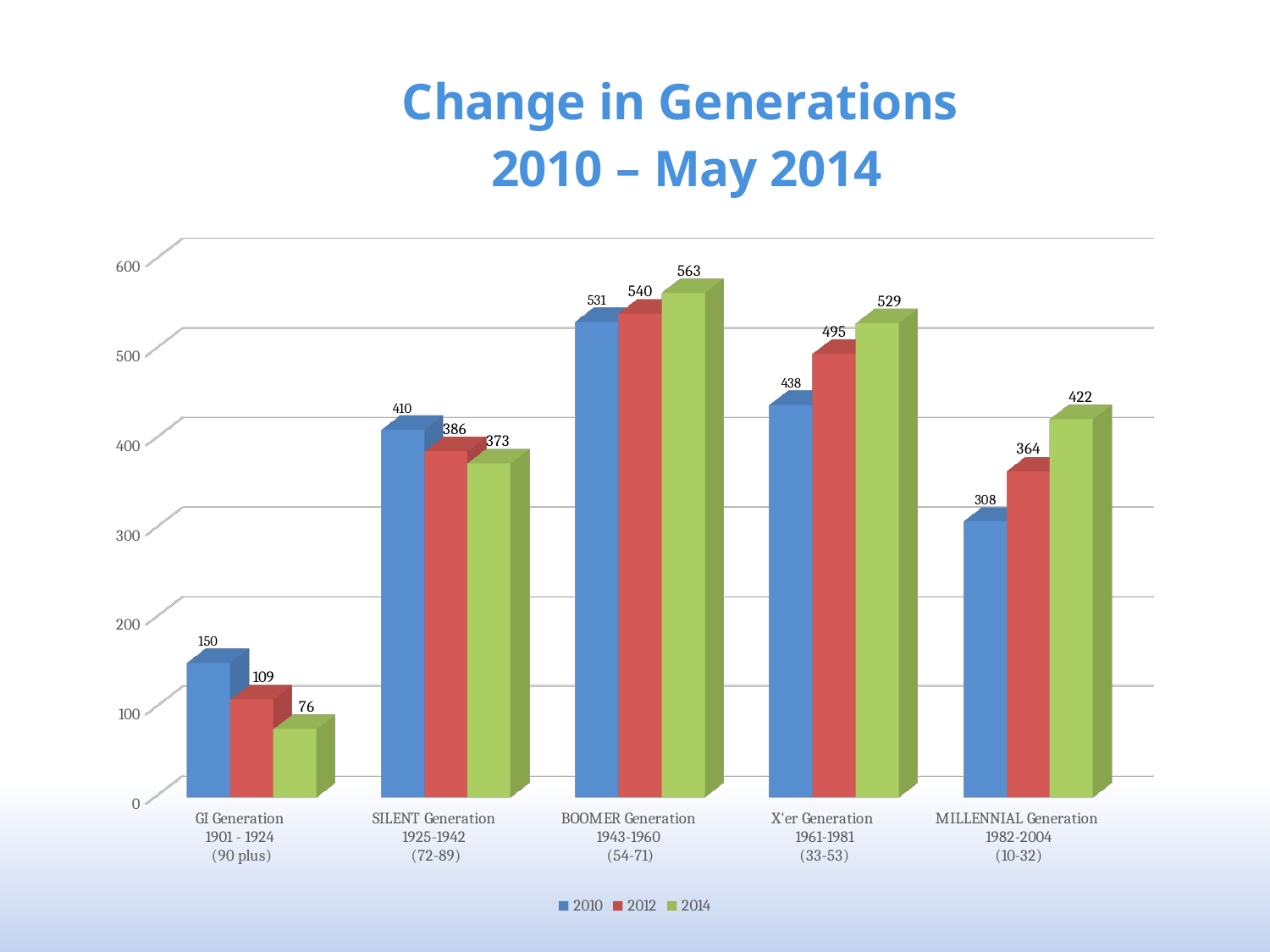
Do the values for the GI Generation rise or fall from 2010 to 2014? Fall How many series does the legend list? 3 What is the difference between the 2010 and 2014 values for the SILENT Generation? 37 Which is larger for the X'er Generation, the 2012 value or the 2014 value? 2014 What is the difference between the 2014 and 2010 values for the MILLENNIAL Generation? 114 What is the 2014 value for the BOOMER Generation? 563 What is the 2012 value for the MILLENNIAL Generation? 364 Which generation has the highest 2014 value? BOOMER Generation How many generations are shown on the x axis? 5 What kind of chart is shown on the slide? Bar chart Which generation has the lowest 2010 value? GI Generation What is the 2010 value for the GI Generation? 150